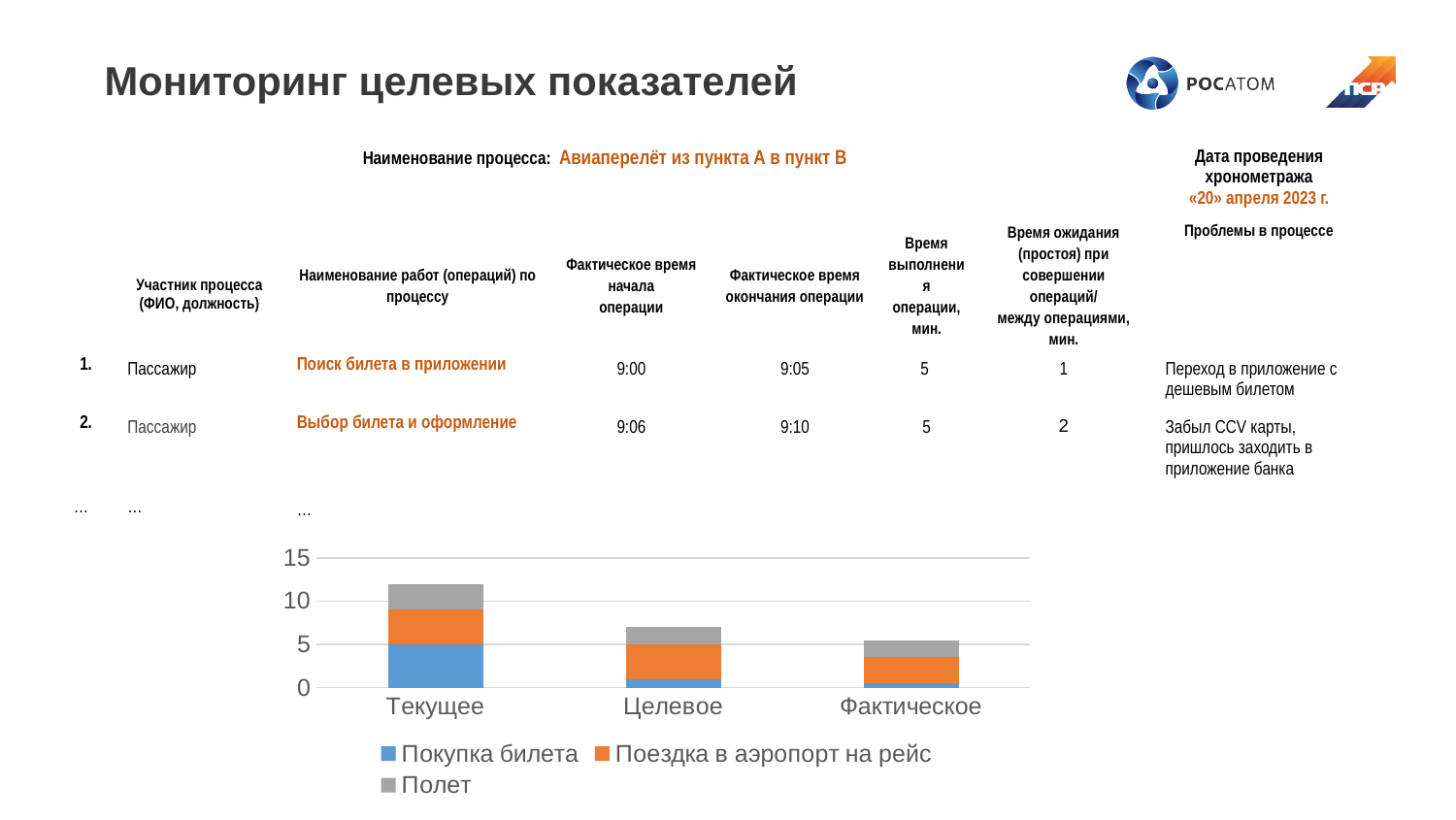
Which category has the tallest stacked bar in the chart? Текущее How many categories are shown on the x axis of the chart? 3 Which category has the shortest stacked bar in the chart? Фактическое Is the total height of the Целевое bar greater or less than 10? less Which series is shown in blue in the chart? Покупка билета What kind of chart is shown on the slide? stacked bar chart Is the total height of the Текущее bar greater or less than 10? greater Which category has the larger Покупка билета segment, Текущее or Целевое? Текущее Is the total height of the Фактическое bar greater or less than 10? less How many series does the chart legend list? 3 Which series is shown in gray in the chart? Полет Do the total bar heights rise or fall from Текущее to Фактическое along the x axis? fall